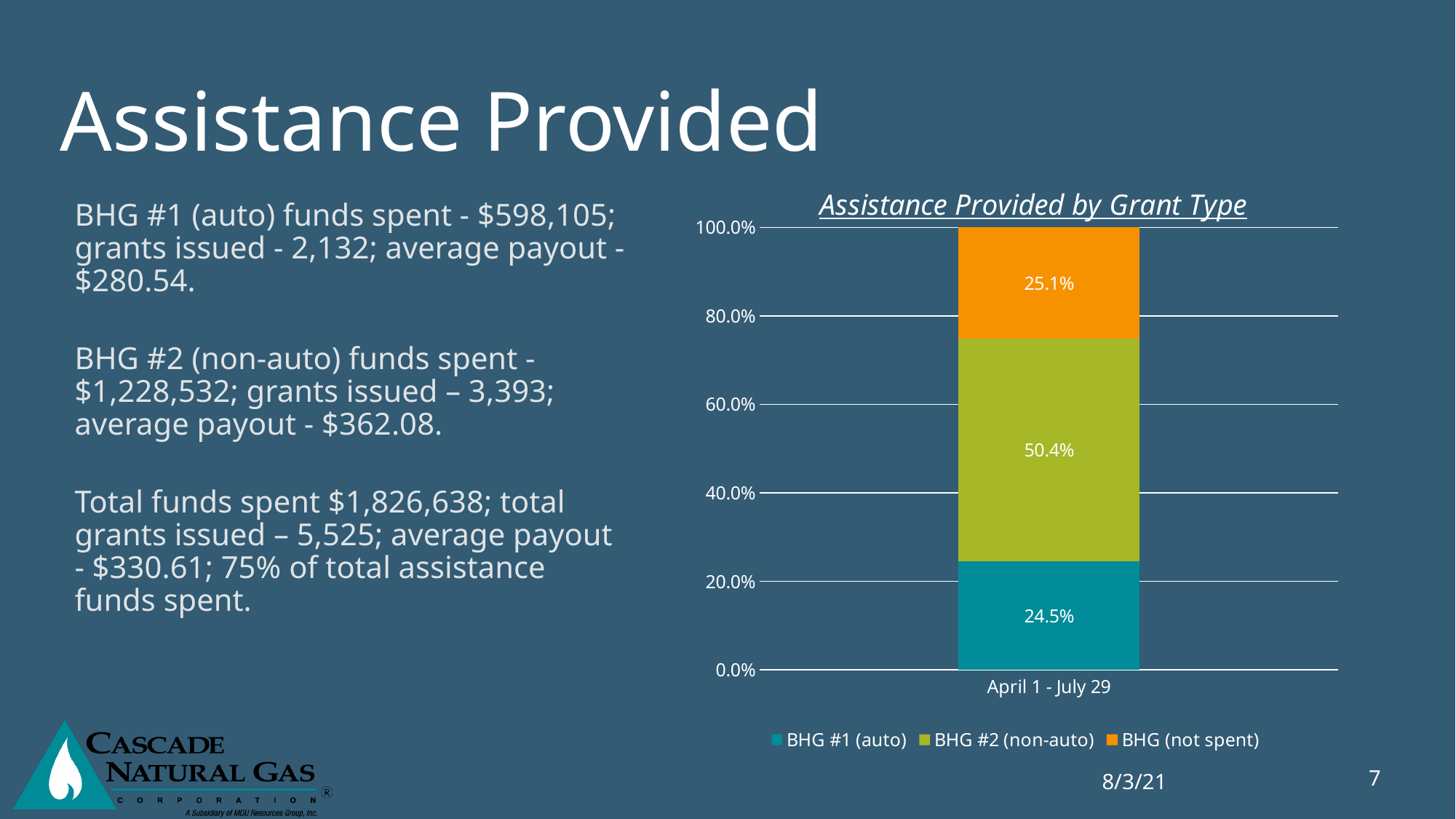
What is the difference between the BHG (not spent) value and the BHG #1 (auto) value? 0.6% Is the value for BHG #2 (non-auto) greater or less than 40.0%? greater What is the title of the chart? Assistance Provided by Grant Type How many series does the legend list? 3 How many categories are shown on the x axis? 1 Which series has the largest share of the stacked bar? BHG #2 (non-auto) What kind of chart is shown on the slide? Stacked bar chart What is the value for BHG (not spent) in the Assistance Provided by Grant Type chart? 25.1% What is the value for BHG #1 (auto) in the Assistance Provided by Grant Type chart? 24.5% What is the difference between the BHG #2 (non-auto) value and the BHG #1 (auto) value? 25.9% Which series has the smallest share of the stacked bar? BHG #1 (auto) What is the value for BHG #2 (non-auto) in the Assistance Provided by Grant Type chart? 50.4%